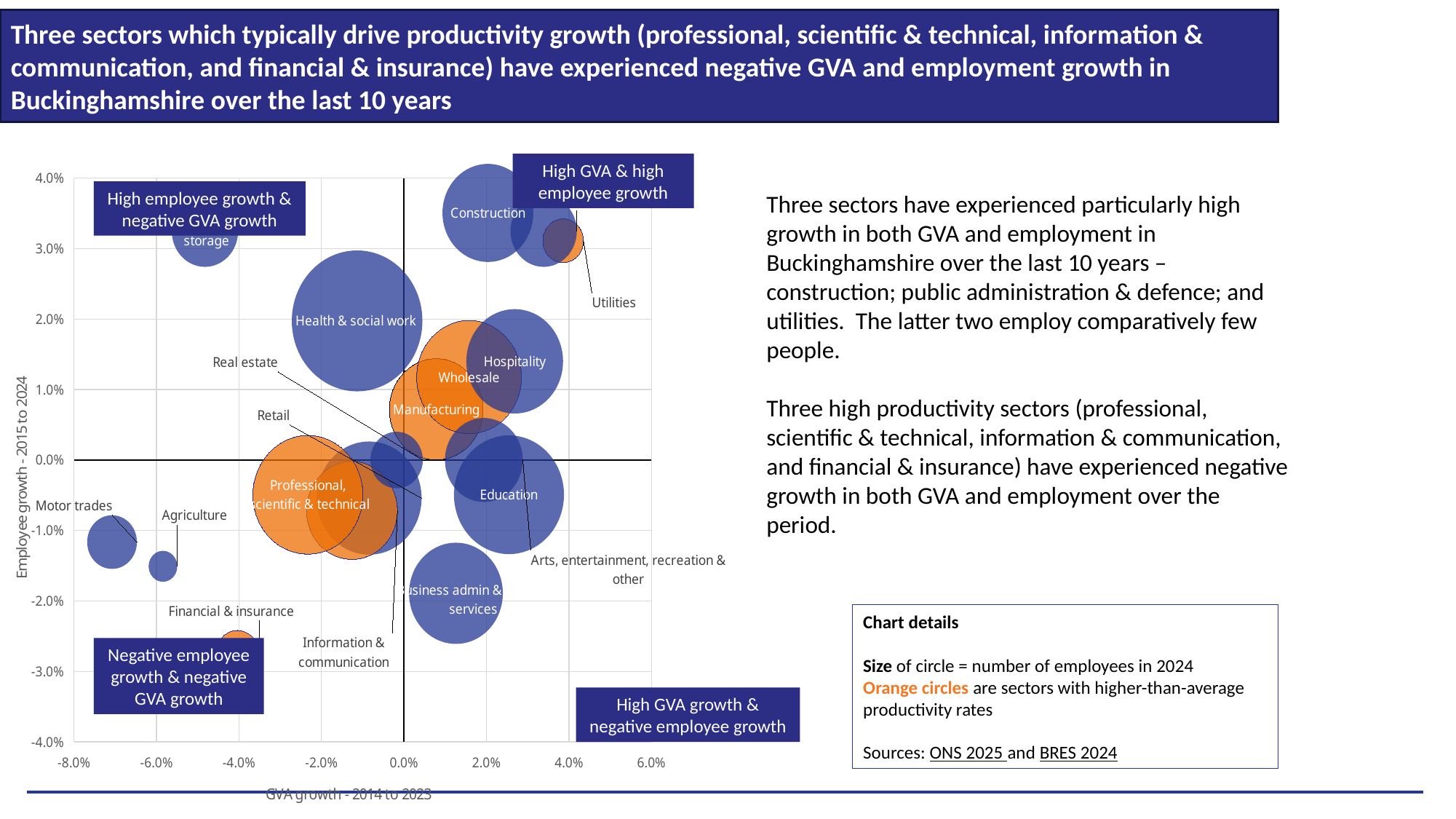
Which sector has higher employee growth, Health & social work or Education? Health & social work Is the GVA growth value for Education greater or less than 0.0%? greater Which sector has higher GVA growth, Construction or Agriculture? Construction Is the employee growth value for Health & social work greater or less than 1.0%? greater Is the employee growth value for Business admin & services greater or less than -1.0%? less What kind of chart is shown on the slide? Bubble chart Which sector has the lowest GVA growth on the chart? Motor trades What does the horizontal axis of the chart measure? GVA growth - 2014 to 2023 According to the chart details box, what does the size of a circle represent? Number of employees in 2024